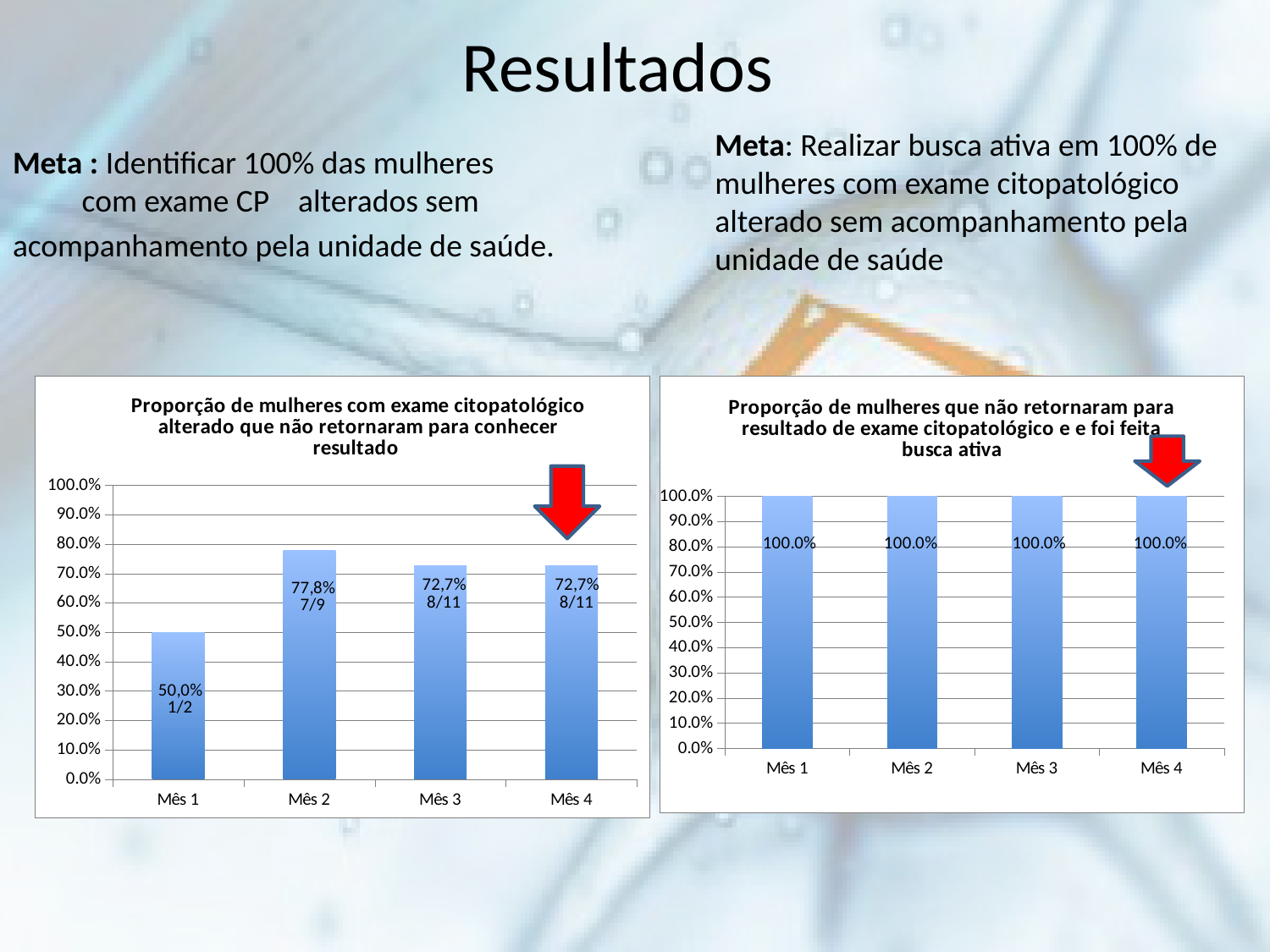
How many charts are shown on the slide? 2 In the left chart (Proporção de mulheres com exame citopatológico alterado que não retornaram para conhecer resultado), what is the value for Mês 2? 77,8% In the left chart (Proporção de mulheres com exame citopatológico alterado que não retornaram para conhecer resultado), which month has the lowest value? Mês 1 In the left chart (Proporção de mulheres com exame citopatológico alterado que não retornaram para conhecer resultado), which is larger, the value for Mês 2 or Mês 3? Mês 2 In the left chart (Proporção de mulheres com exame citopatológico alterado que não retornaram para conhecer resultado), what is the value for Mês 1? 50,0% What kind of chart is the right chart (Proporção de mulheres que não retornaram para resultado de exame citopatológico e e foi feita busca ativa)? bar chart In the left chart (Proporção de mulheres com exame citopatológico alterado que não retornaram para conhecer resultado), what is the difference between the values for Mês 2 and Mês 1? 27,8% In the right chart (Proporção de mulheres que não retornaram para resultado de exame citopatológico e e foi feita busca ativa), do the values rise, fall or stay the same from Mês 1 to Mês 4? stay the same In the left chart (Proporção de mulheres com exame citopatológico alterado que não retornaram para conhecer resultado), what fraction is shown under the percentage for Mês 3? 8/11 In the left chart (Proporção de mulheres com exame citopatológico alterado que não retornaram para conhecer resultado), which month has the highest value? Mês 2 In the right chart (Proporção de mulheres que não retornaram para resultado de exame citopatológico e e foi feita busca ativa), what is the value for Mês 4? 100.0% In the left chart (Proporção de mulheres com exame citopatológico alterado que não retornaram para conhecer resultado), how many months are shown on the x axis? 4